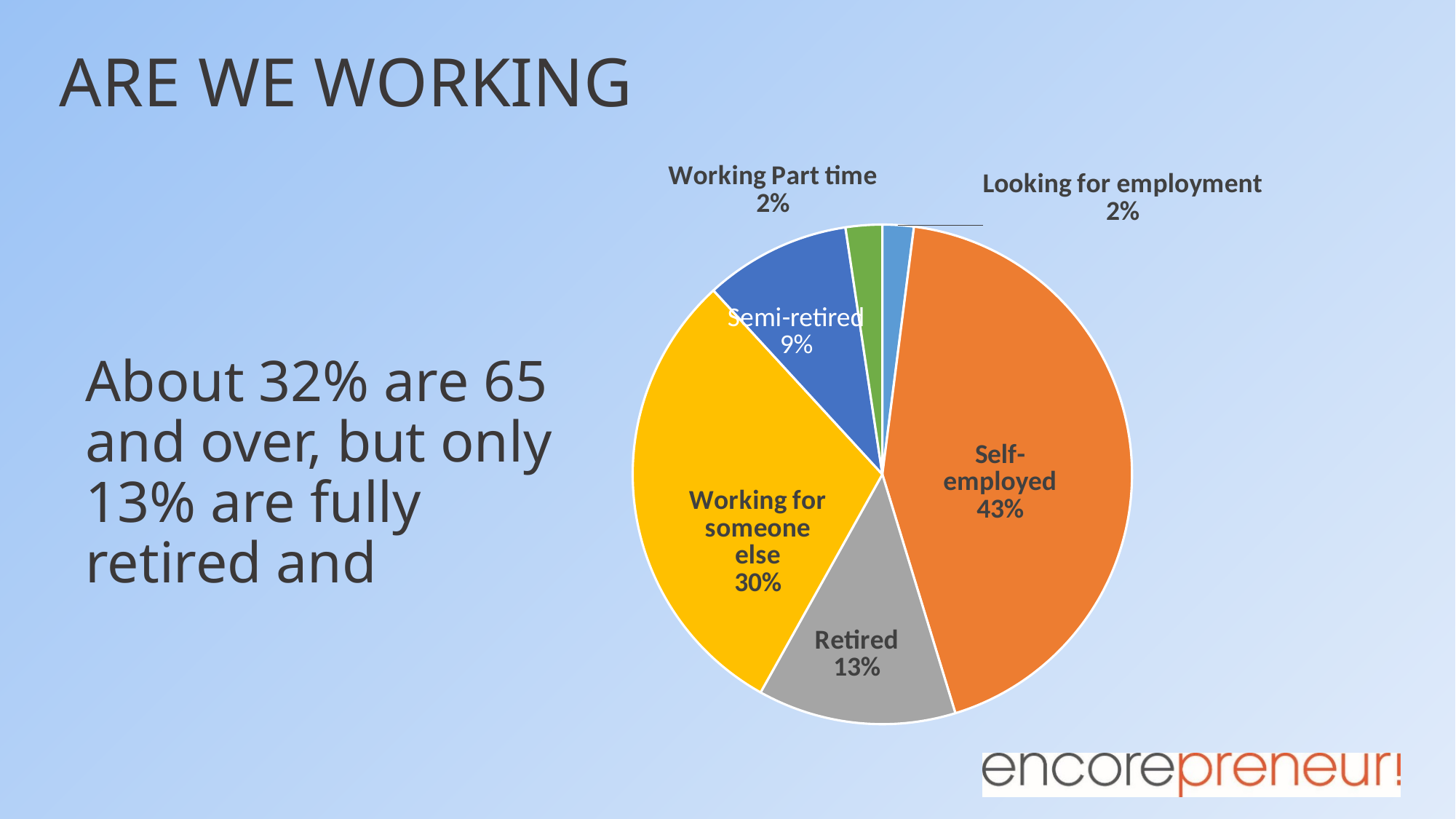
Which category has the largest slice of the pie? Self-employed How many slices does the pie chart have? 6 What share of the pie is Working Part time? 2% What colour is the Self-employed slice? orange Which is larger, the Retired share or the Semi-retired share? Retired What kind of chart is shown on the slide? pie chart What share of the pie is Working for someone else? 30% What share of the pie is Semi-retired? 9% What is the difference between the Self-employed share and the Working for someone else share? 13% What is the combined share of Retired and Semi-retired? 22%